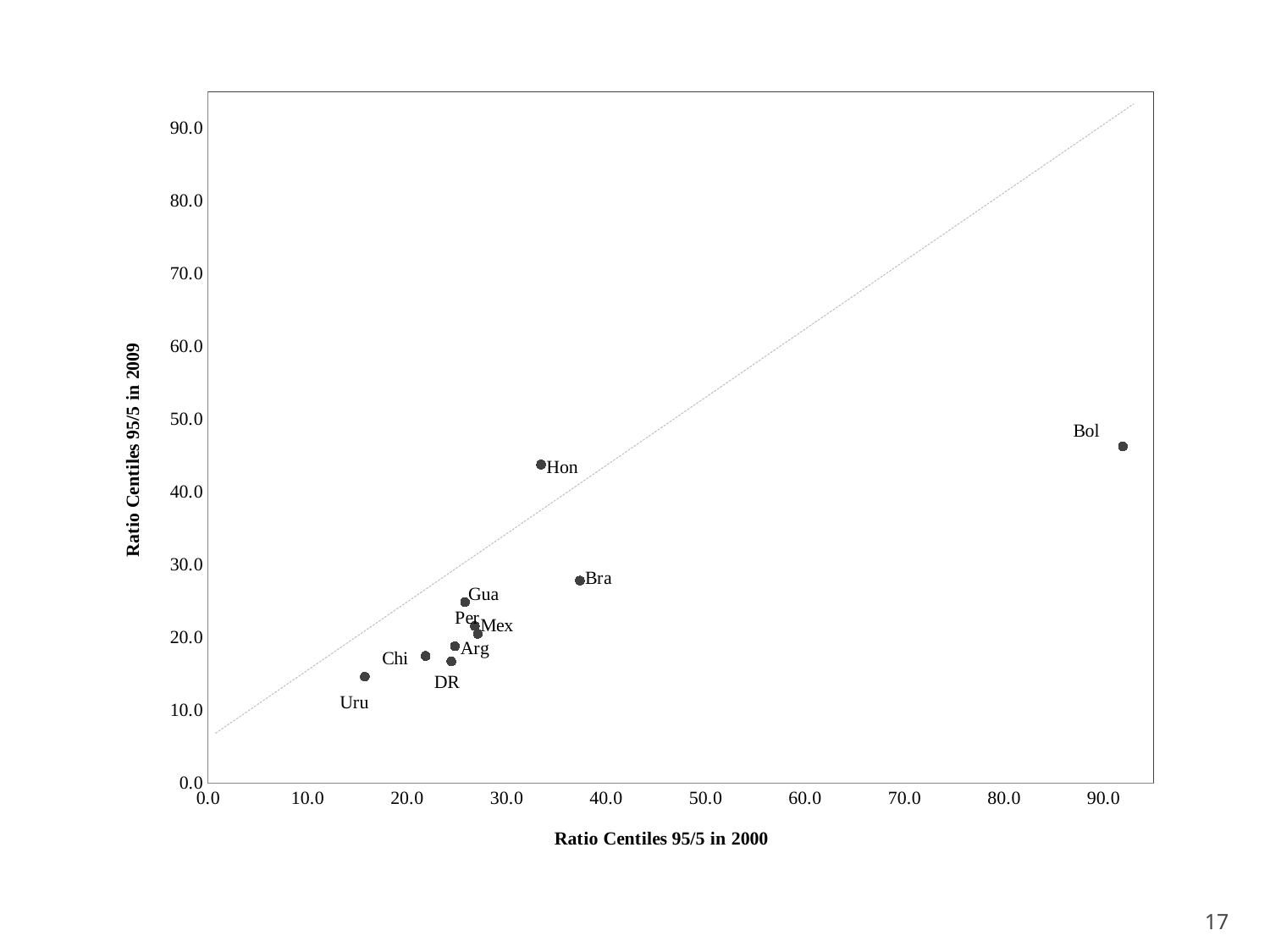
Which country has the lowest Ratio Centiles 95/5 in 2000? Uru What is the title of the vertical axis? Ratio Centiles 95/5 in 2009 What kind of chart is shown on the slide? scatter chart Is the Ratio Centiles 95/5 in 2009 for Bol greater or less than 50.0? less Is the Ratio Centiles 95/5 in 2000 for Bra greater or less than 30.0? greater Is the Ratio Centiles 95/5 in 2000 for Bol greater or less than 80.0? greater Which has the higher Ratio Centiles 95/5 in 2009, Hon or Bra? Hon Which country has the highest Ratio Centiles 95/5 in 2000? Bol What is the title of the horizontal axis? Ratio Centiles 95/5 in 2000 How many labelled country points are plotted on the chart? 10